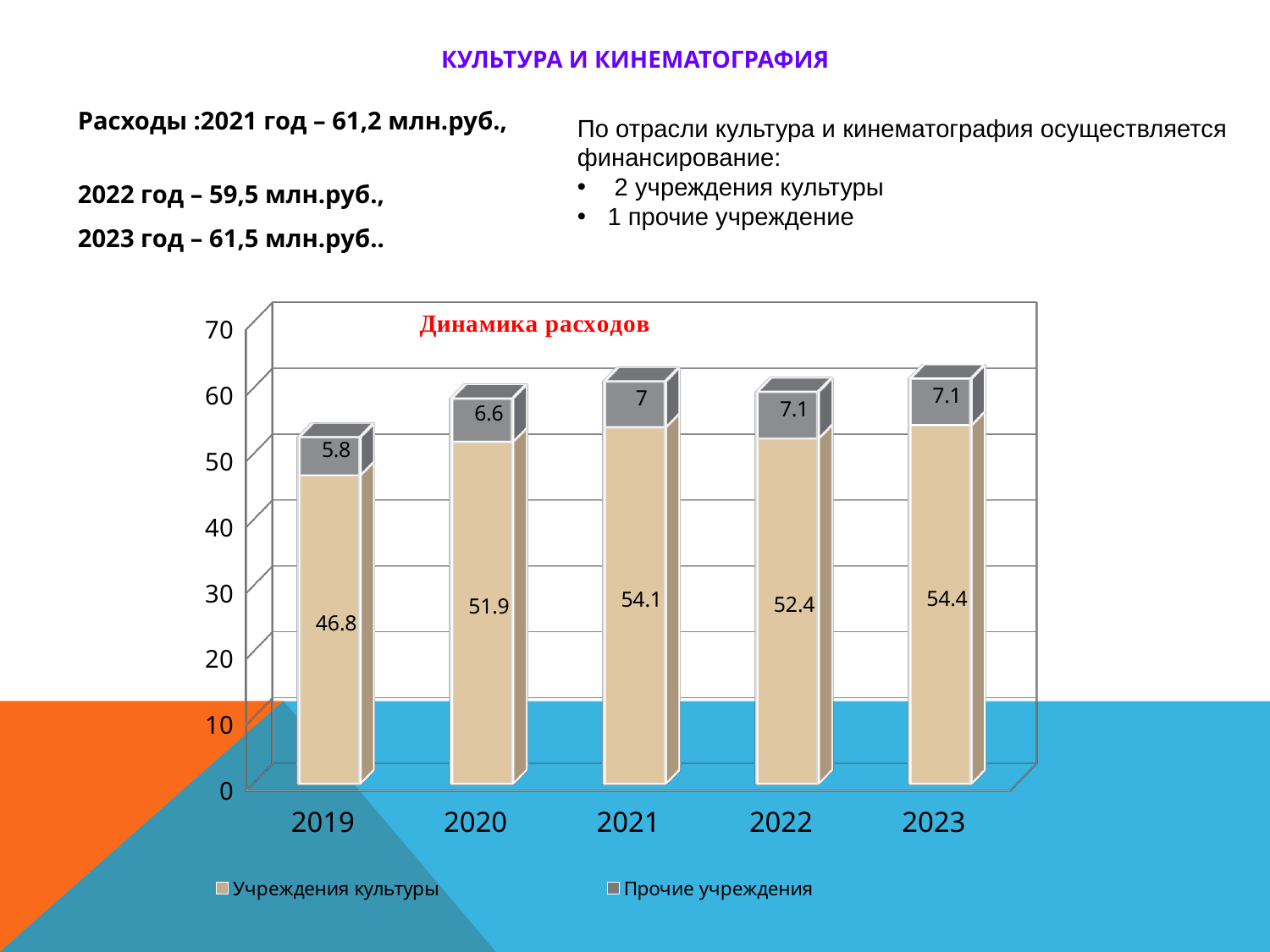
How many series does the legend list? 2 In which year is the value for Учреждения культуры the lowest? 2019 Which is larger, the Прочие учреждения value for 2020 or for 2019? 2020 What is the value for Прочие учреждения in 2021? 7 How many years are shown on the x axis? 5 What is the difference between the Учреждения культуры values for 2020 and 2019? 5.1 What is the value for Учреждения культуры in 2019? 46.8 What is the total of the stacked bar for 2019? 52.6 In which year is the value for Учреждения культуры the highest? 2023 What is the total of the stacked bar for 2022? 59.5 What is the title of the chart? Динамика расходов What is the value for Учреждения культуры in 2023? 54.4